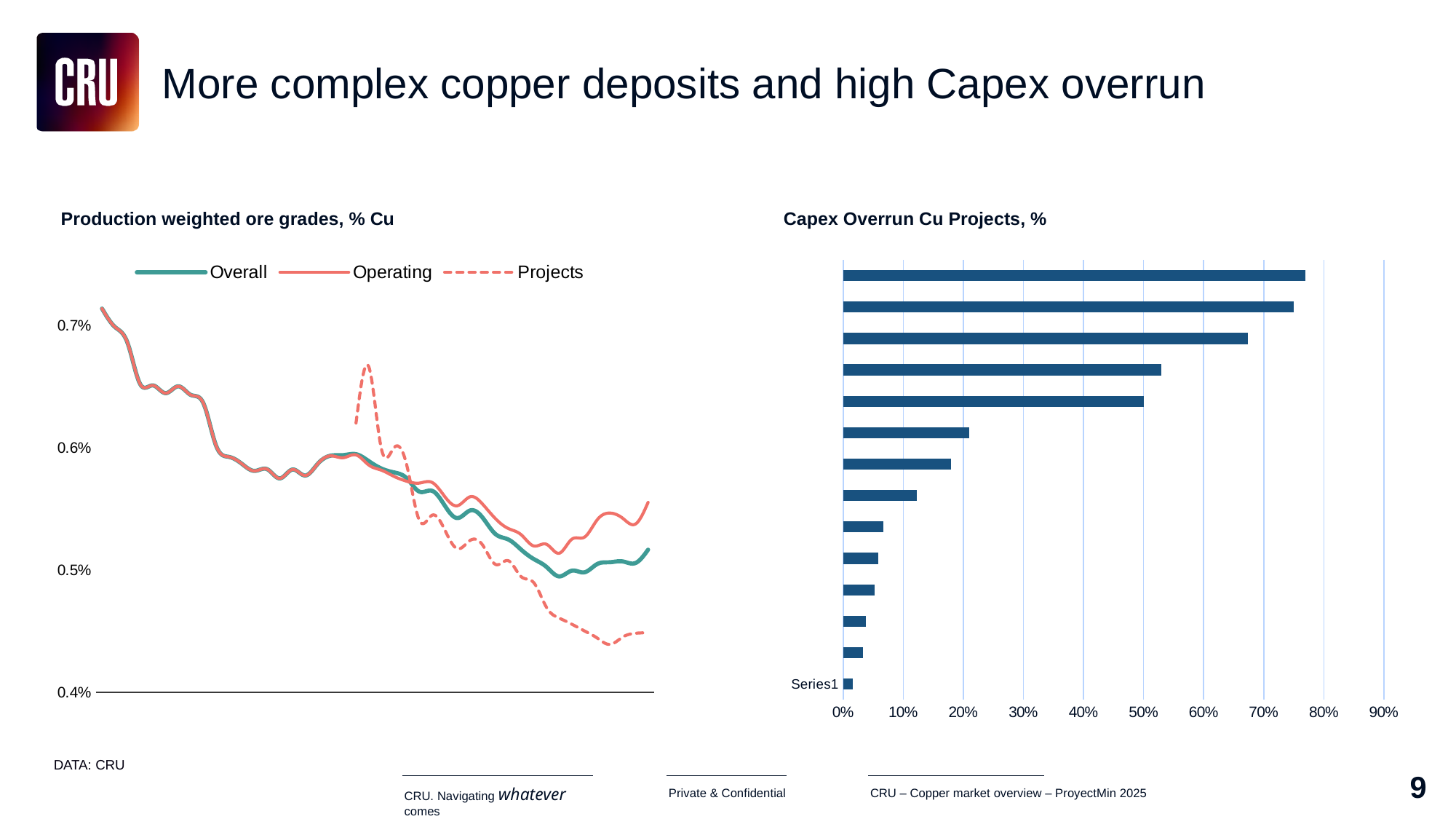
In the 'Production weighted ore grades, % Cu' chart, is the Projects value at the right end greater or less than 0.5%? less What kind of chart is the 'Production weighted ore grades, % Cu' chart on the left? line chart In the 'Production weighted ore grades, % Cu' chart, which series is lowest at the right end of the chart? Projects How many series does the legend of the 'Production weighted ore grades, % Cu' chart list? 3 In the 'Capex Overrun Cu Projects, %' chart, is the longest bar greater or less than 70%? greater How many bars are plotted in the 'Capex Overrun Cu Projects, %' chart? 14 In the 'Production weighted ore grades, % Cu' chart, do the Overall values rise or fall from left to right overall? fall In the 'Capex Overrun Cu Projects, %' chart, is the bar labelled Series1 greater or less than 10%? less In the 'Production weighted ore grades, % Cu' chart, which series is drawn with a dashed line? Projects What kind of chart is the 'Capex Overrun Cu Projects, %' chart on the right? bar chart What are the legend entries of the 'Production weighted ore grades, % Cu' chart? Overall, Operating, Projects